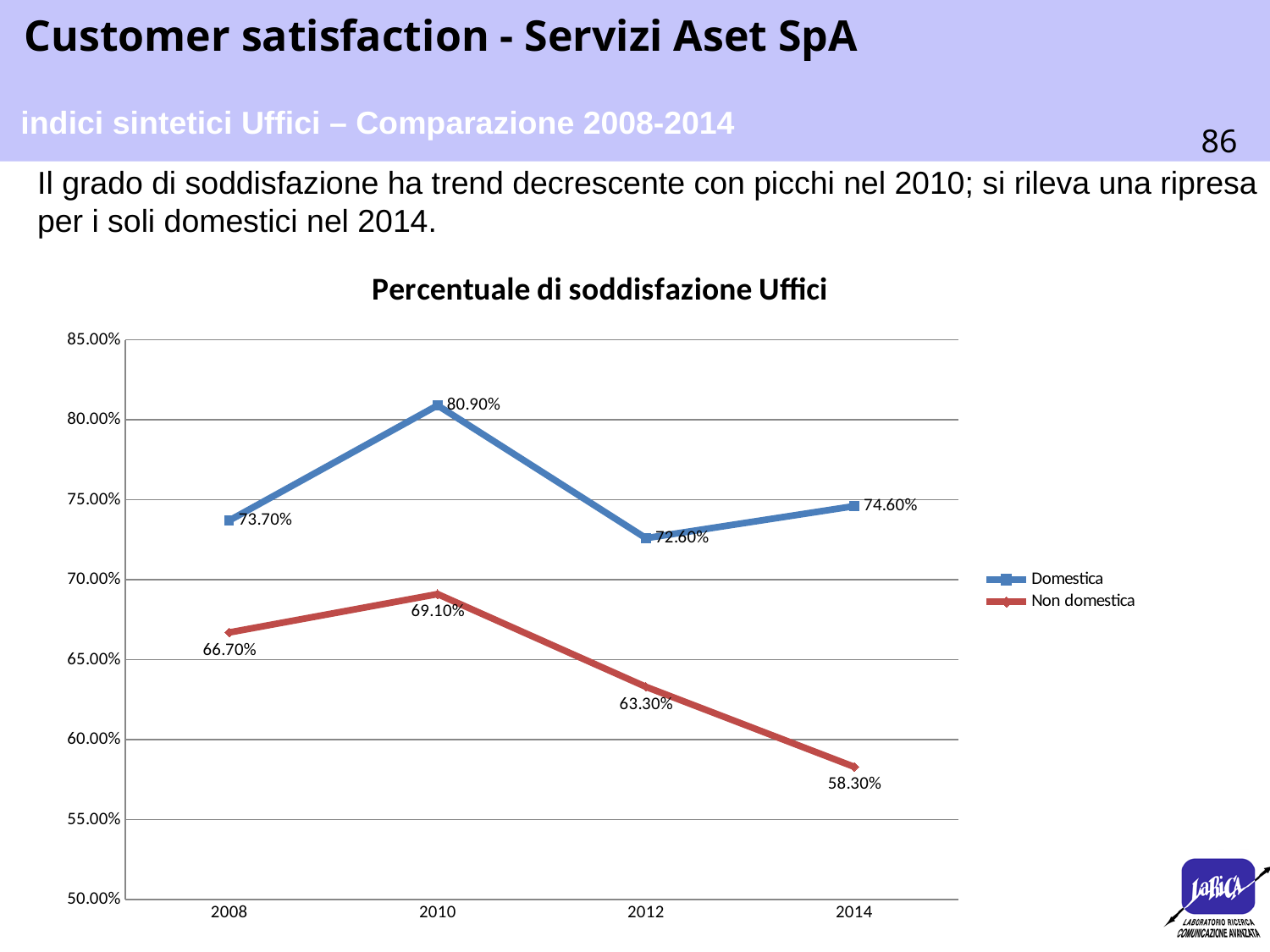
What is the difference between the Domestica and Non domestica values in 2014? 16.30% Is the value for Non domestica in 2010 greater or less than 70.00%? less In which year is the Non domestica series lowest? 2014 Which series has the larger value in 2012, Domestica or Non domestica? Domestica What is the value for Domestica in 2008? 73.70% What kind of chart is shown on the slide? line chart What is the value for Non domestica in 2014? 58.30% How many years are shown on the x axis? 4 In which year is the Domestica series highest? 2010 What is the value for Non domestica in 2012? 63.30% What is the value for Domestica in 2010? 80.90% How many series does the legend list? 2